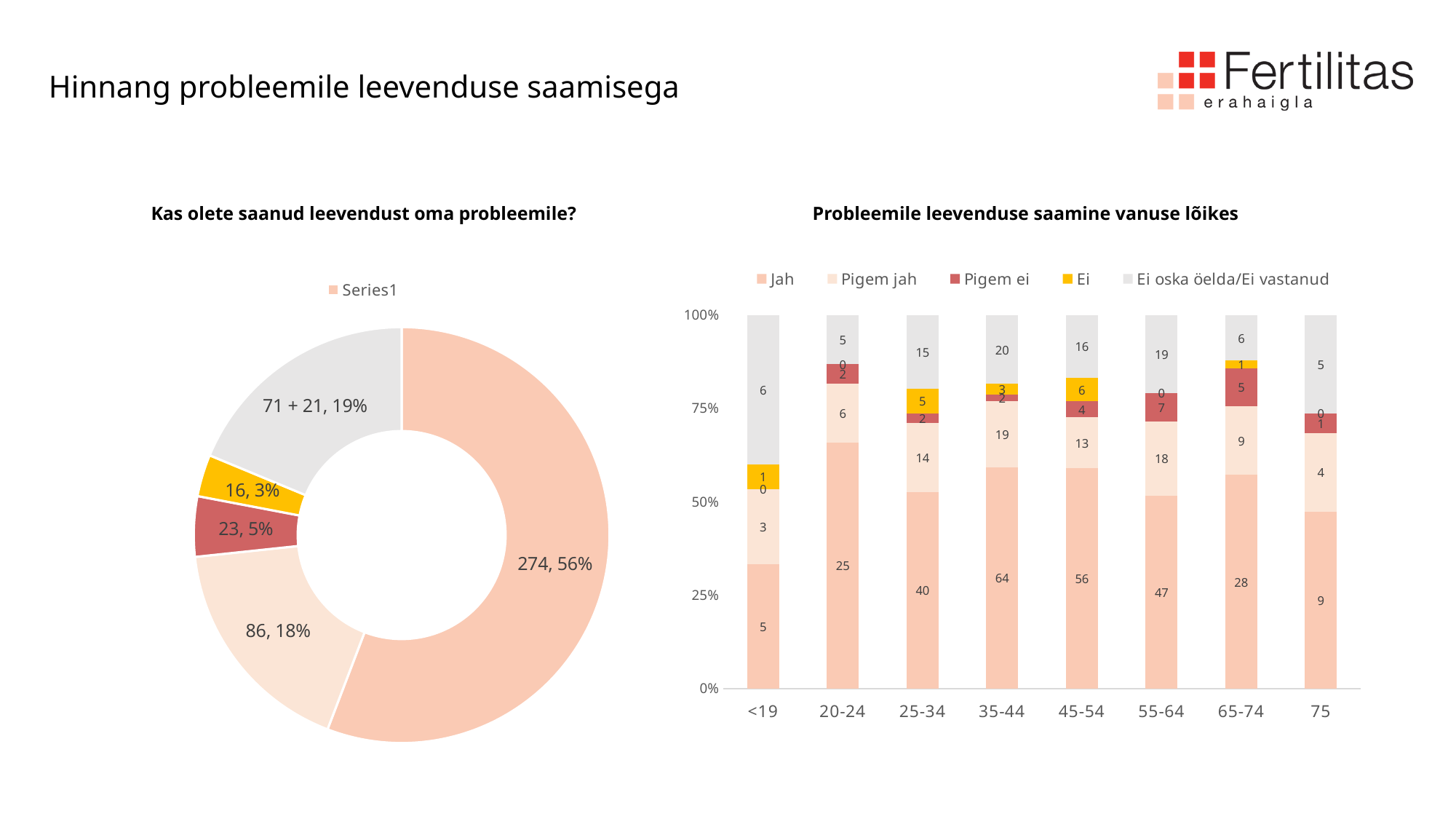
In the chart "Probleemile leevenduse saamine vanuse lõikes", what is the "Ei" value for the 45-54 age group? 6 In the chart "Probleemile leevenduse saamine vanuse lõikes", which is larger: the "Pigem jah" value for 35-44 or for 65-74? 35-44 In the chart "Probleemile leevenduse saamine vanuse lõikes", what is the total of all labelled values in the 20-24 bar? 38 How many age groups are shown on the x axis of the chart "Probleemile leevenduse saamine vanuse lõikes"? 8 In the chart "Probleemile leevenduse saamine vanuse lõikes", what is the "Jah" value for the 35-44 age group? 64 In the chart "Probleemile leevenduse saamine vanuse lõikes", what is the difference between the "Jah" values for 45-54 and 55-64? 9 In the chart "Kas olete saanud leevendust oma probleemile?", what share does the yellow slice represent? 3% How many series does the legend of the chart "Probleemile leevenduse saamine vanuse lõikes" list? 5 What kind of chart is the chart titled "Probleemile leevenduse saamine vanuse lõikes"? Stacked bar chart In the chart "Probleemile leevenduse saamine vanuse lõikes", what is the "Ei oska öelda/Ei vastanud" value for the 25-34 age group? 15 In the chart "Probleemile leevenduse saamine vanuse lõikes", which age group has the highest "Jah" value? 35-44 In the chart "Kas olete saanud leevendust oma probleemile?", what is the data label on the largest slice? 274, 56%